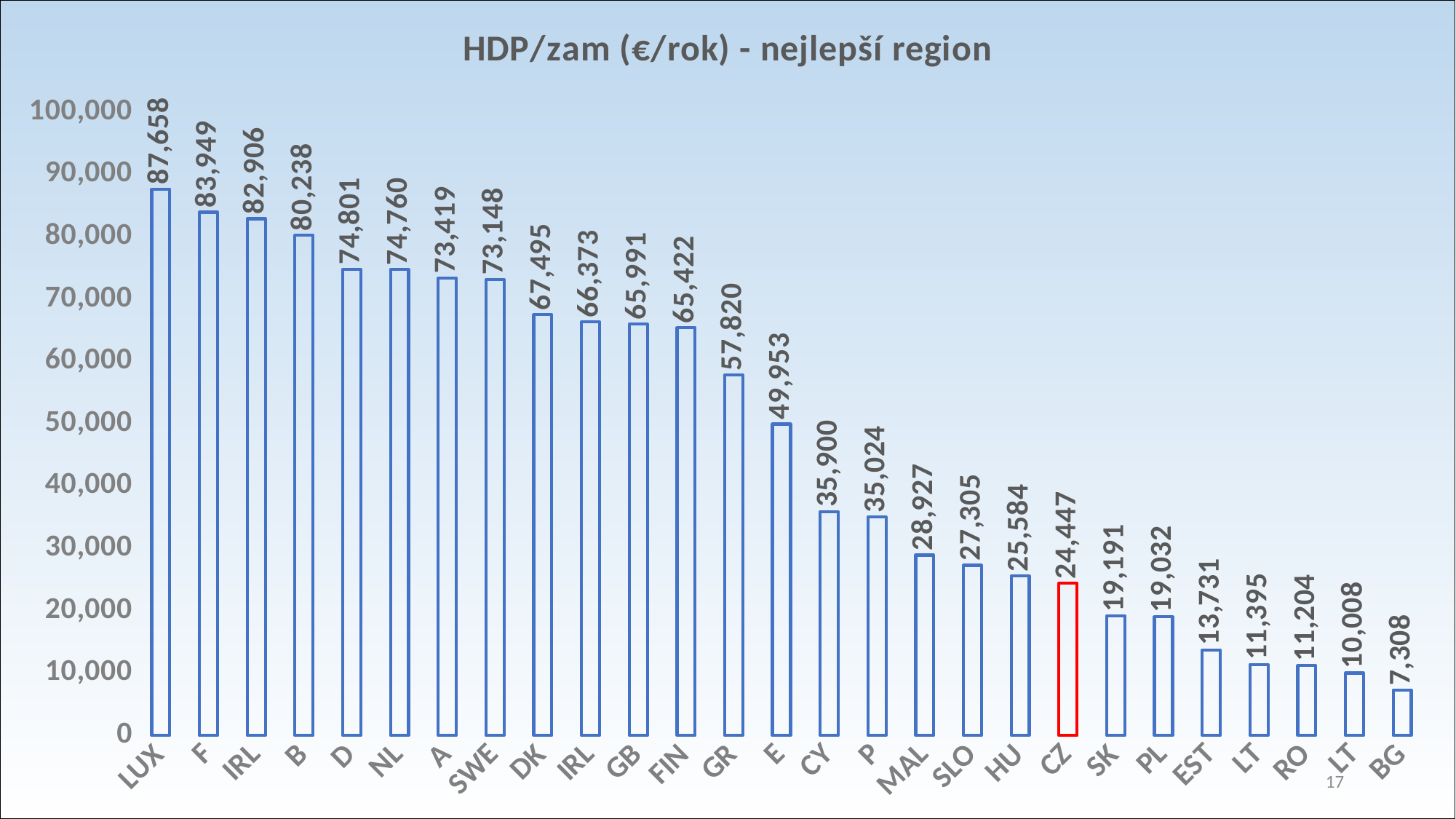
What is the value for CZ? 24,447 Which category has the highest value? LUX What is the difference between the values for CZ and SK? 5,256 What kind of chart is this? bar chart Which bar is outlined in red? CZ What is the value for BG? 7,308 What is the value for GR? 57,820 Which is larger, the value for E or the value for CY? E What is the value for LUX? 87,658 Which category has the lowest value? BG How many categories are shown on the x axis? 27 What is the difference between the values for LUX and BG? 80,350